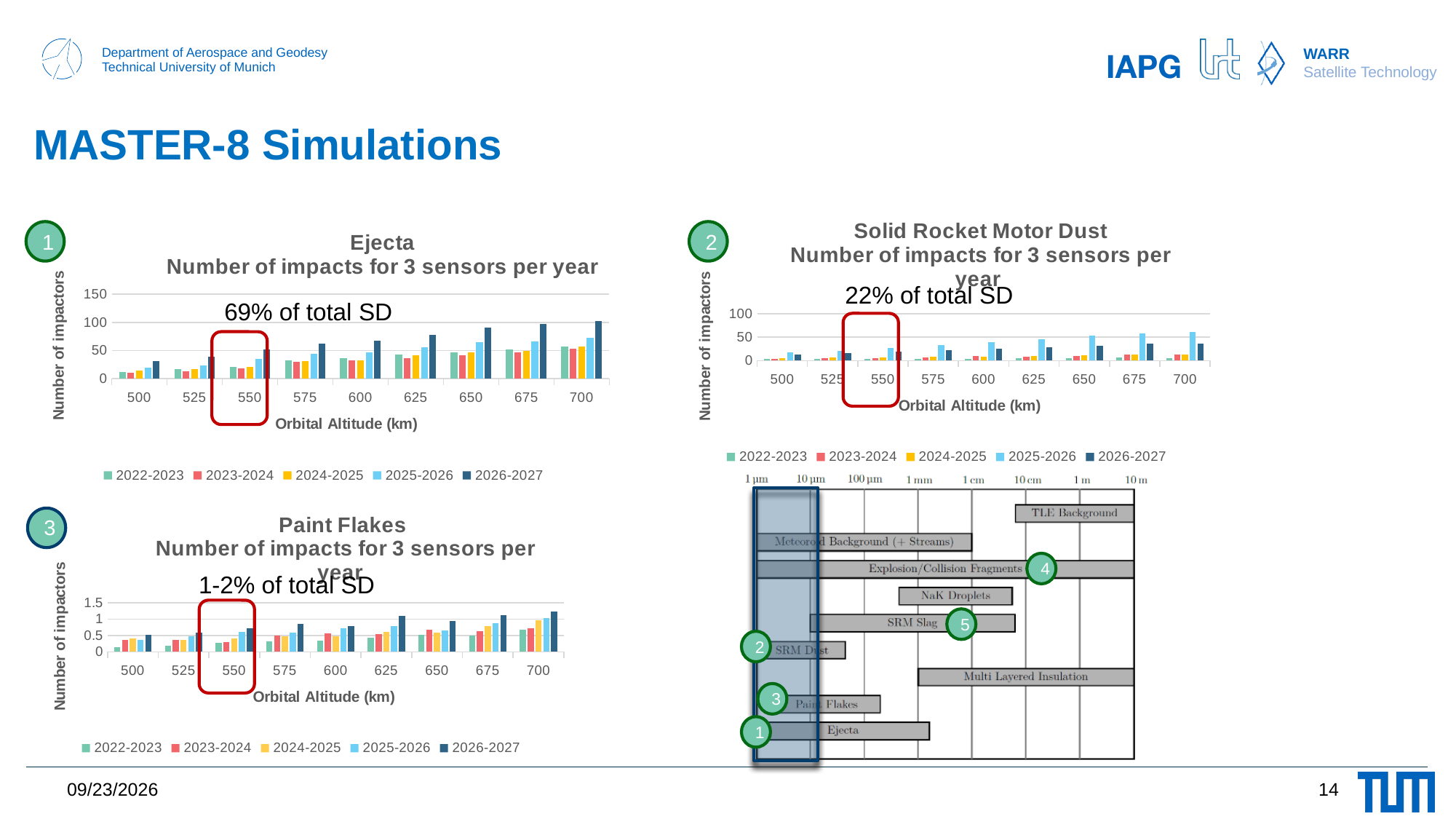
In the "Solid Rocket Motor Dust" chart, is the value for 2025-2026 at 700 km greater or less than 50? greater In the "Solid Rocket Motor Dust" chart, at 700 km, which is larger: 2025-2026 or 2026-2027? 2025-2026 In the "Ejecta" chart, is the value for 2026-2027 at 700 km greater or less than 50? greater What kind of chart is the "Ejecta" chart? bar chart In the "Ejecta" chart, do the 2026-2027 values rise or fall as orbital altitude increases from 500 to 700 km? rise In the "Paint Flakes" chart, is the value for 2026-2027 at 700 km greater or less than 1? greater In the "Ejecta" chart, at which orbital altitude is the 2026-2027 series highest? 700 What percentage of total SD is annotated on the "Ejecta" chart? 69% of total SD How many orbital altitude categories are shown on the x axis of the "Paint Flakes" chart? 9 How many series does the legend of the "Solid Rocket Motor Dust" chart list? 5